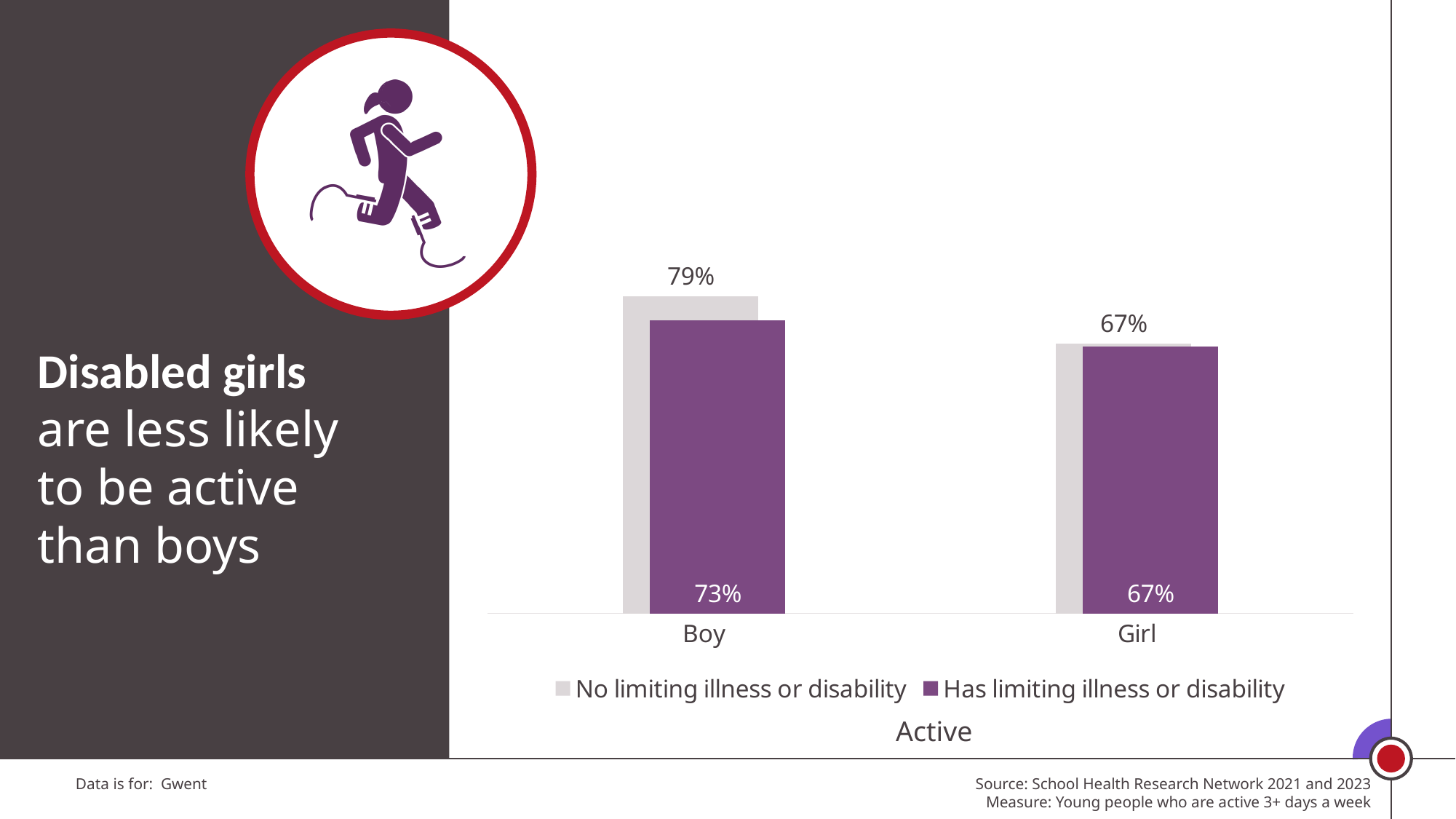
What is the difference between the 'No limiting illness or disability' and 'Has limiting illness or disability' values for boys? 6% What percentage of girls with no limiting illness or disability are active? 67% How many series does the chart legend list? 2 What kind of chart is shown on the slide? Bar chart What percentage of boys with no limiting illness or disability are active? 79% How many categories are shown on the x axis of the chart? 2 What is the difference between the 'Has limiting illness or disability' values for boys and girls? 6% What percentage of boys who have a limiting illness or disability are active? 73% Which category has the lowest value for 'Has limiting illness or disability'? Girl Which is larger: the 'Has limiting illness or disability' value for boys or for girls? Boy What percentage of girls who have a limiting illness or disability are active? 67% Which category has the highest value for 'No limiting illness or disability'? Boy